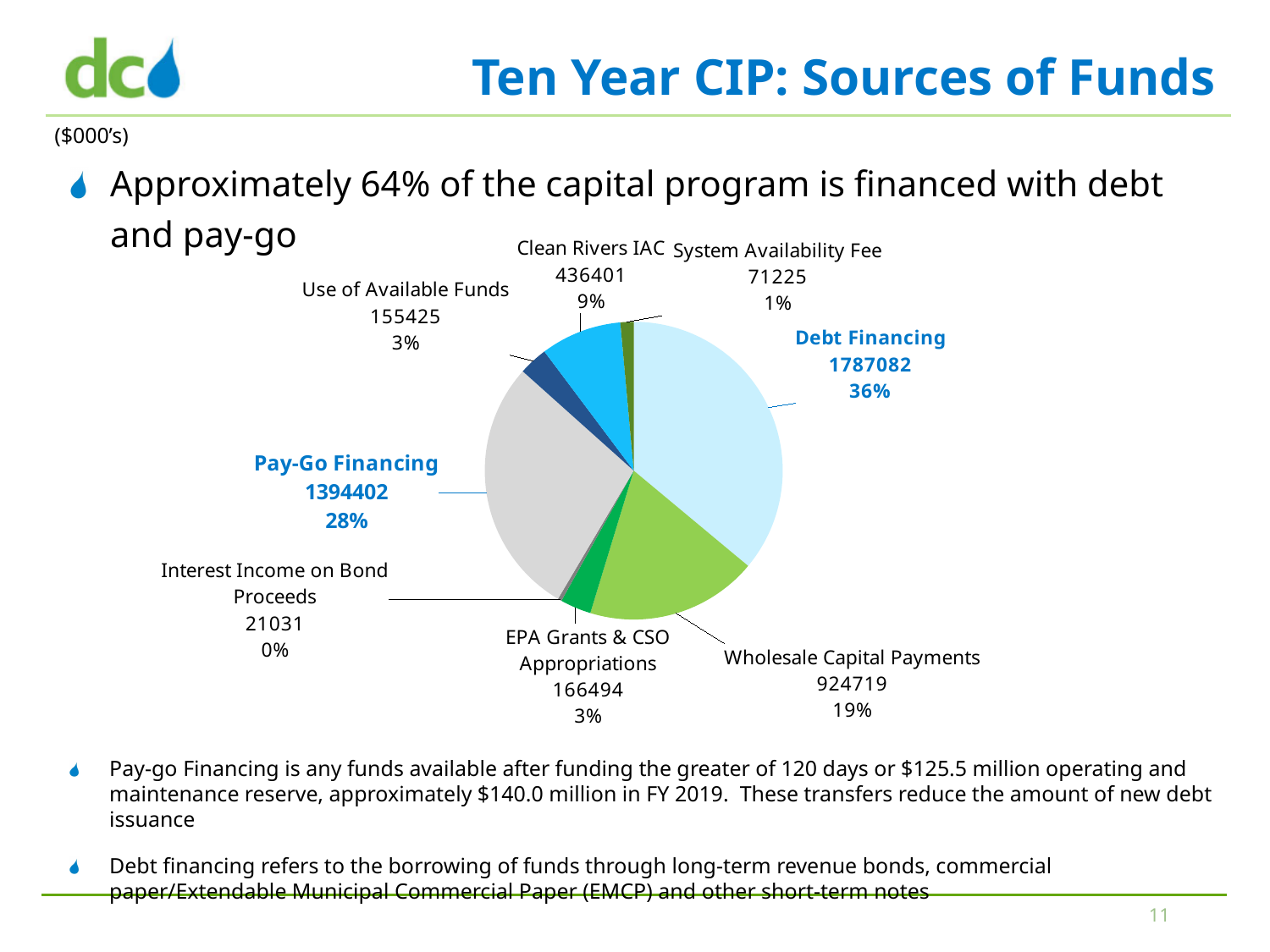
Which is larger, Use of Available Funds or EPA Grants & CSO Appropriations? EPA Grants & CSO Appropriations What is the title of the slide containing the chart? Ten Year CIP: Sources of Funds Which source of funds is the smallest? Interest Income on Bond Proceeds What type of chart is shown on the slide? Pie chart What is the value for System Availability Fee? 71225 What is the value for Wholesale Capital Payments? 924719 How many slices does the pie chart have? 8 What is the value for Debt Financing? 1787082 What percentage share does Clean Rivers IAC have? 9% What percentage share does Pay-Go Financing have? 28% Which source of funds is the largest? Debt Financing What is the difference between Debt Financing and Pay-Go Financing? 392680